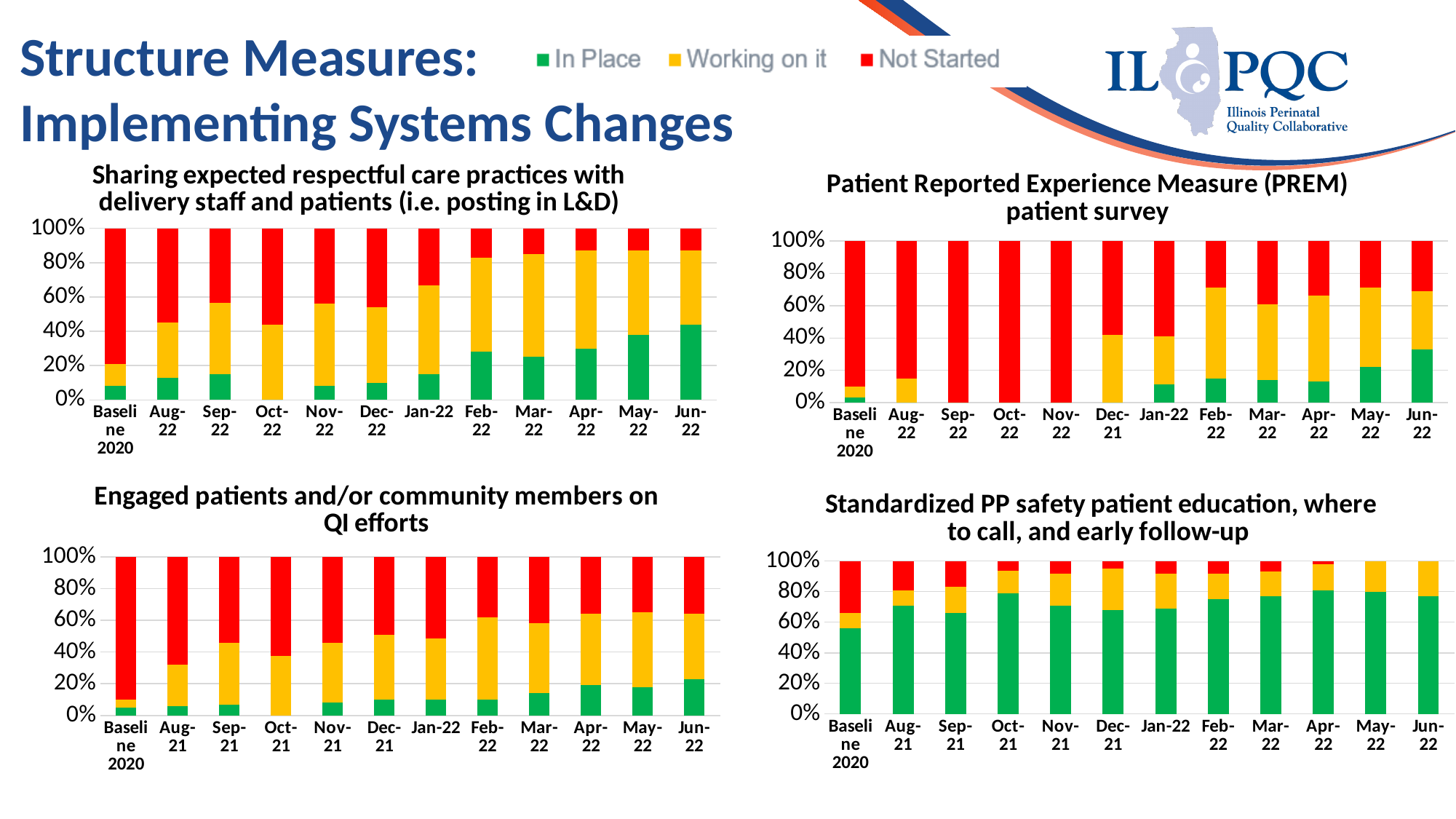
Which colour represents 'Not Started' in the legend? red In the 'Engaged patients and/or community members on QI efforts' chart, does the In Place share generally rise or fall from Baseline 2020 to Jun-22? rise In the 'Sharing expected respectful care practices with delivery staff and patients (i.e. posting in L&D)' chart, does the Not Started share generally rise or fall from Baseline 2020 to Jun-22? fall In the 'Engaged patients and/or community members on QI efforts' chart, is the Not Started value for Baseline 2020 greater or less than 80%? greater What is the title of the chart in the bottom-right of the slide? Standardized PP safety patient education, where to call, and early follow-up What kind of chart is the 'Patient Reported Experience Measure (PREM) patient survey' chart? stacked bar chart How many time-period categories are shown on the x axis of the 'Engaged patients and/or community members on QI efforts' chart? 12 In the 'Patient Reported Experience Measure (PREM) patient survey' chart, is the Not Started value for Oct-22 greater or less than 80%? greater In the 'Sharing expected respectful care practices with delivery staff and patients (i.e. posting in L&D)' chart, which period has the largest In Place share? Jun-22 In the 'Standardized PP safety patient education, where to call, and early follow-up' chart, is the In Place value for Baseline 2020 greater or less than 40%? greater How many series does the legend at the top of the slide list? 3 In the 'Standardized PP safety patient education, where to call, and early follow-up' chart, is the In Place share larger for Baseline 2020 or for Oct-21? Oct-21